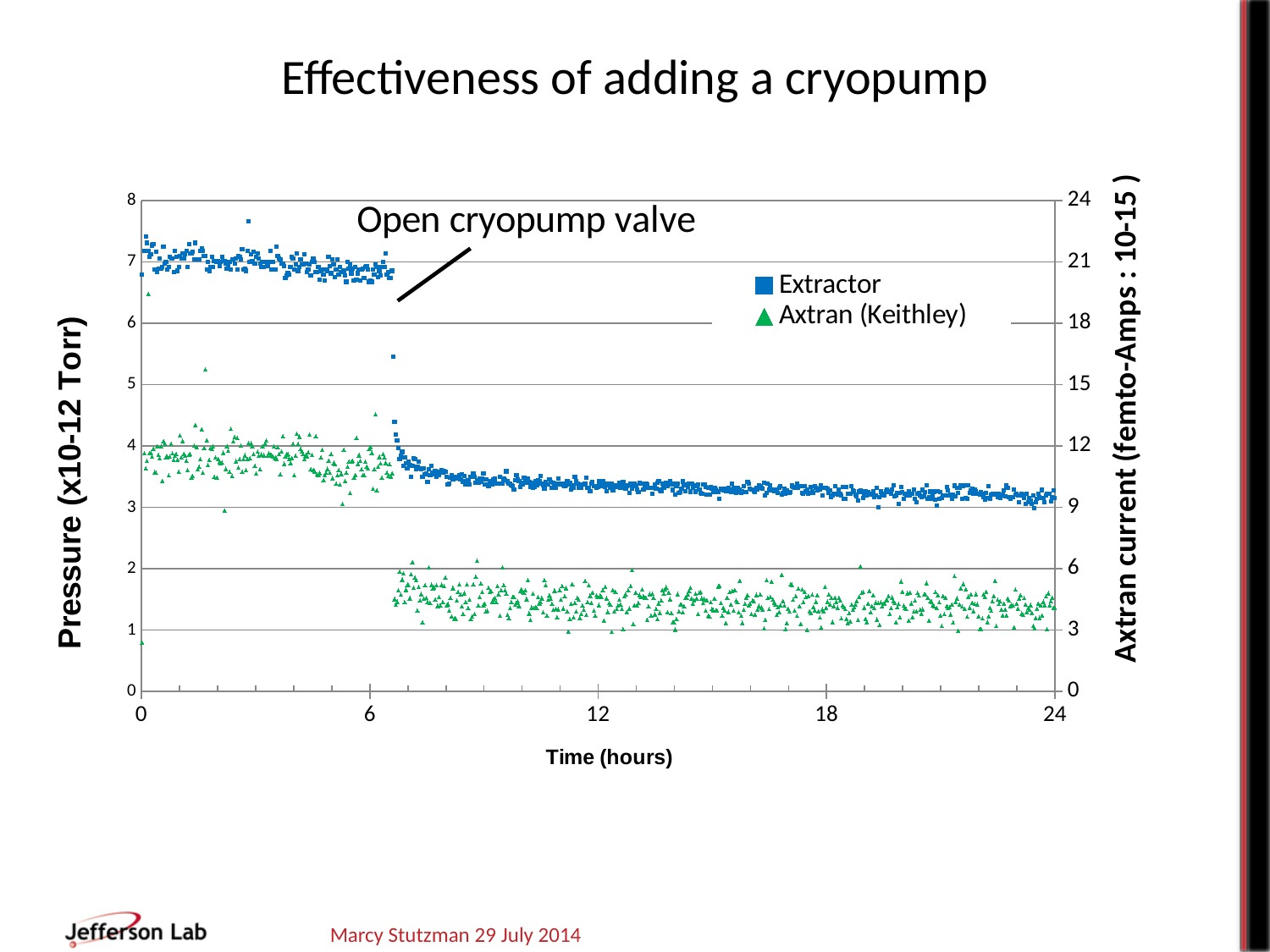
What kind of chart is shown on the slide? scatter chart Does the Extractor pressure rise or fall over the 24 hours shown? fall What is the title of the chart on the slide? Effectiveness of adding a cryopump Is the Extractor pressure at 12 hours greater or less than 3 on the left axis? greater Is the Extractor pressure at 18 hours greater or less than 4 on the left axis? less Is the Axtran (Keithley) current at 3 hours greater or less than 9 on the right axis? greater Does the Axtran (Keithley) current rise or fall over the 24 hours shown? fall Which series has the higher value on the left axis at 12 hours, Extractor or Axtran (Keithley)? Extractor What is the label of the x axis? Time (hours) How many series does the chart legend list? 2